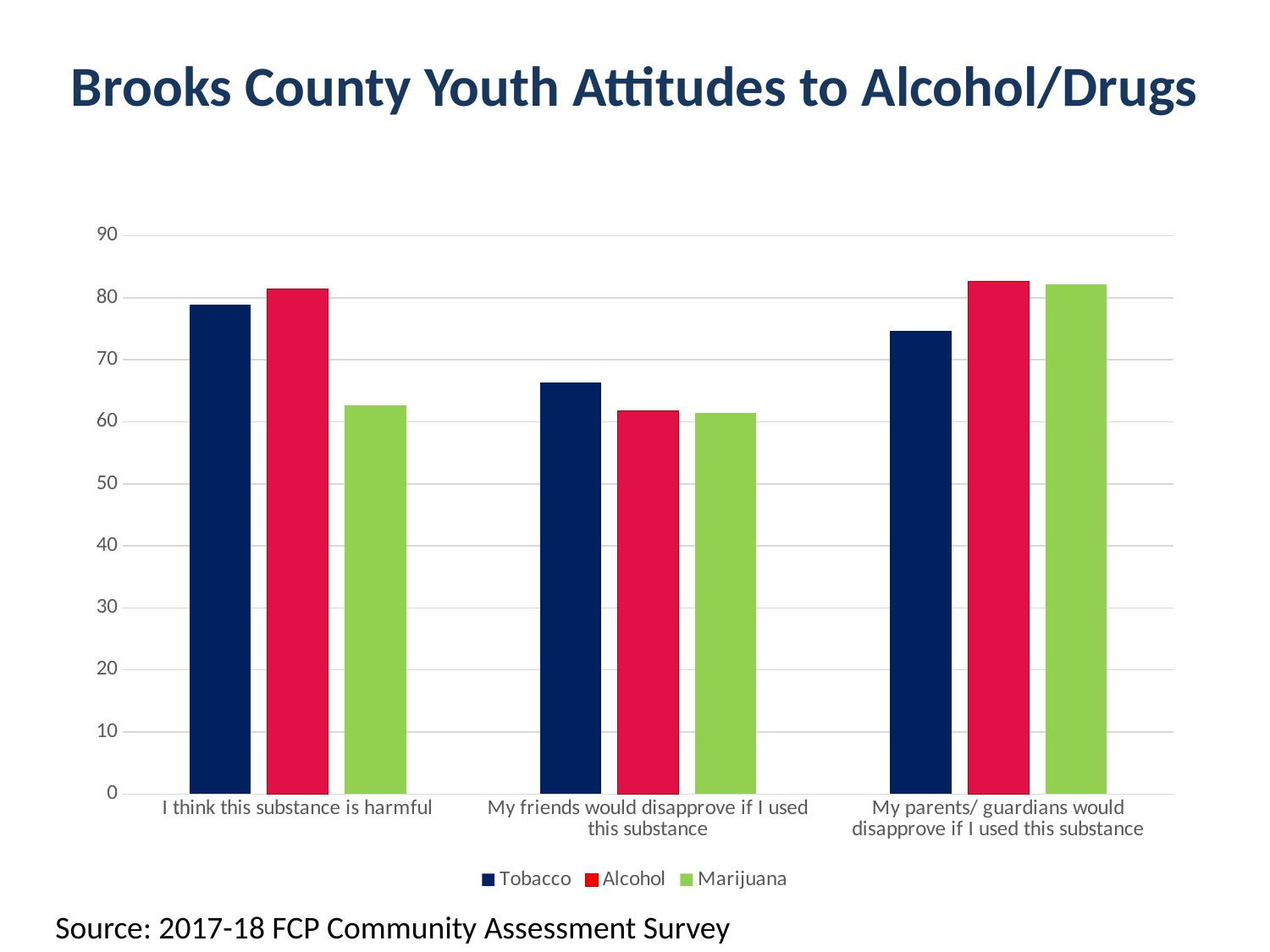
How many categories are shown on the x axis? 3 Is the Tobacco value for "I think this substance is harmful" greater or less than 70? greater Is the Alcohol value for "My parents/ guardians would disapprove if I used this substance" greater or less than 80? greater Is the Tobacco value for "My friends would disapprove if I used this substance" greater or less than 70? less How many series does the legend list? 3 Which substance has the lowest value for "I think this substance is harmful"? Marijuana Which substance has the highest value for "My friends would disapprove if I used this substance"? Tobacco Which colour represents Alcohol in the legend? red Which substance has the lowest value for "My parents/ guardians would disapprove if I used this substance"? Tobacco What kind of chart is shown on the slide? bar chart